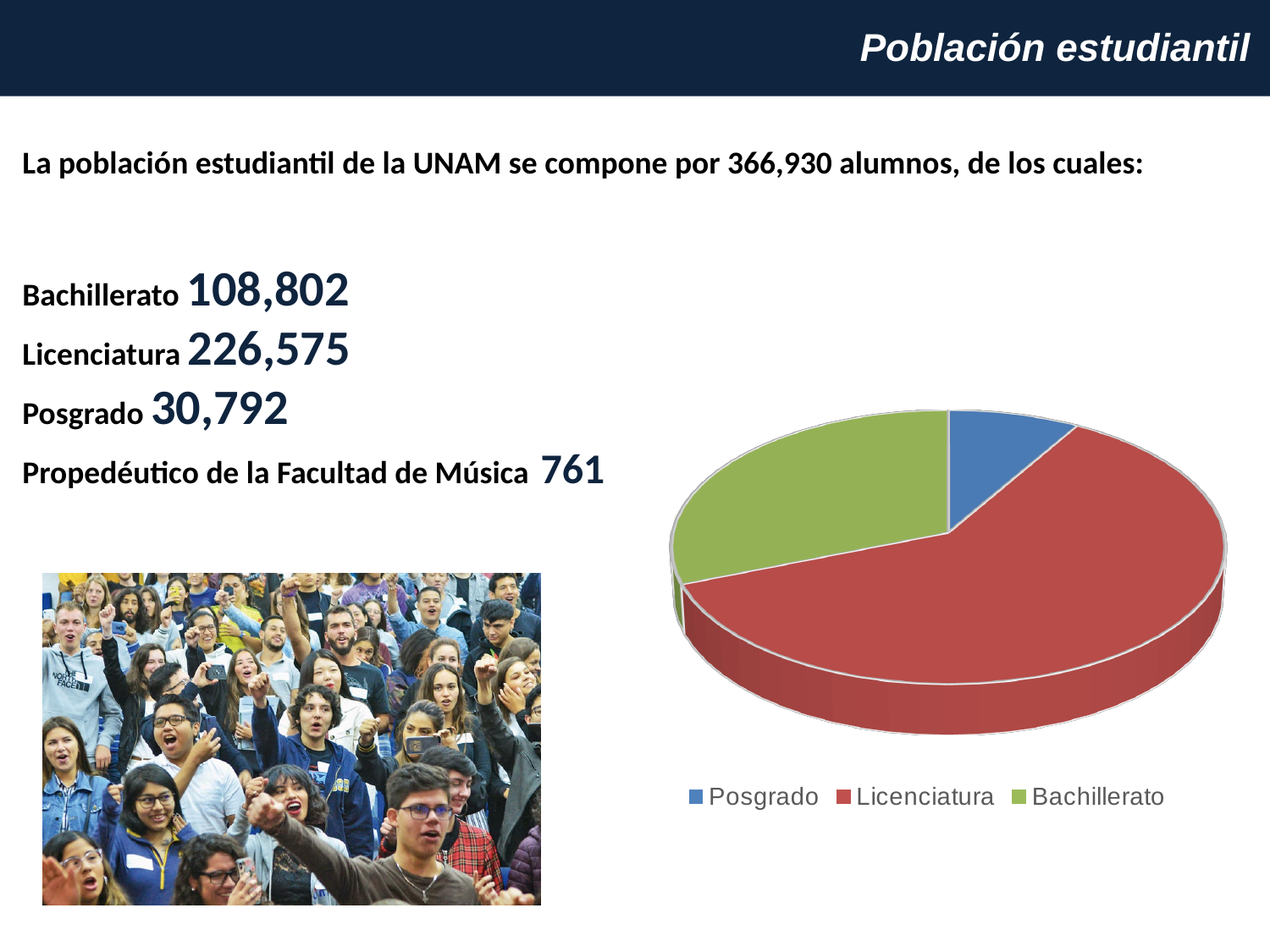
What kind of chart is shown on the slide? pie chart How many slices does the pie chart have? 3 Which slice is larger in the pie chart, Bachillerato or Posgrado? Bachillerato What colour is the Licenciatura slice in the pie chart? red How many categories does the pie chart's legend list? 3 What colour is the Posgrado slice in the pie chart? blue According to the slide, how many students are in Bachillerato? 108,802 Which category has the largest slice in the pie chart? Licenciatura According to the slide, how many students are in Licenciatura? 226,575 Which category has the smallest slice in the pie chart? Posgrado Using the values printed on the slide, how many more students are in Licenciatura than in Bachillerato? 117,773 According to the slide, how many students are in Posgrado? 30,792